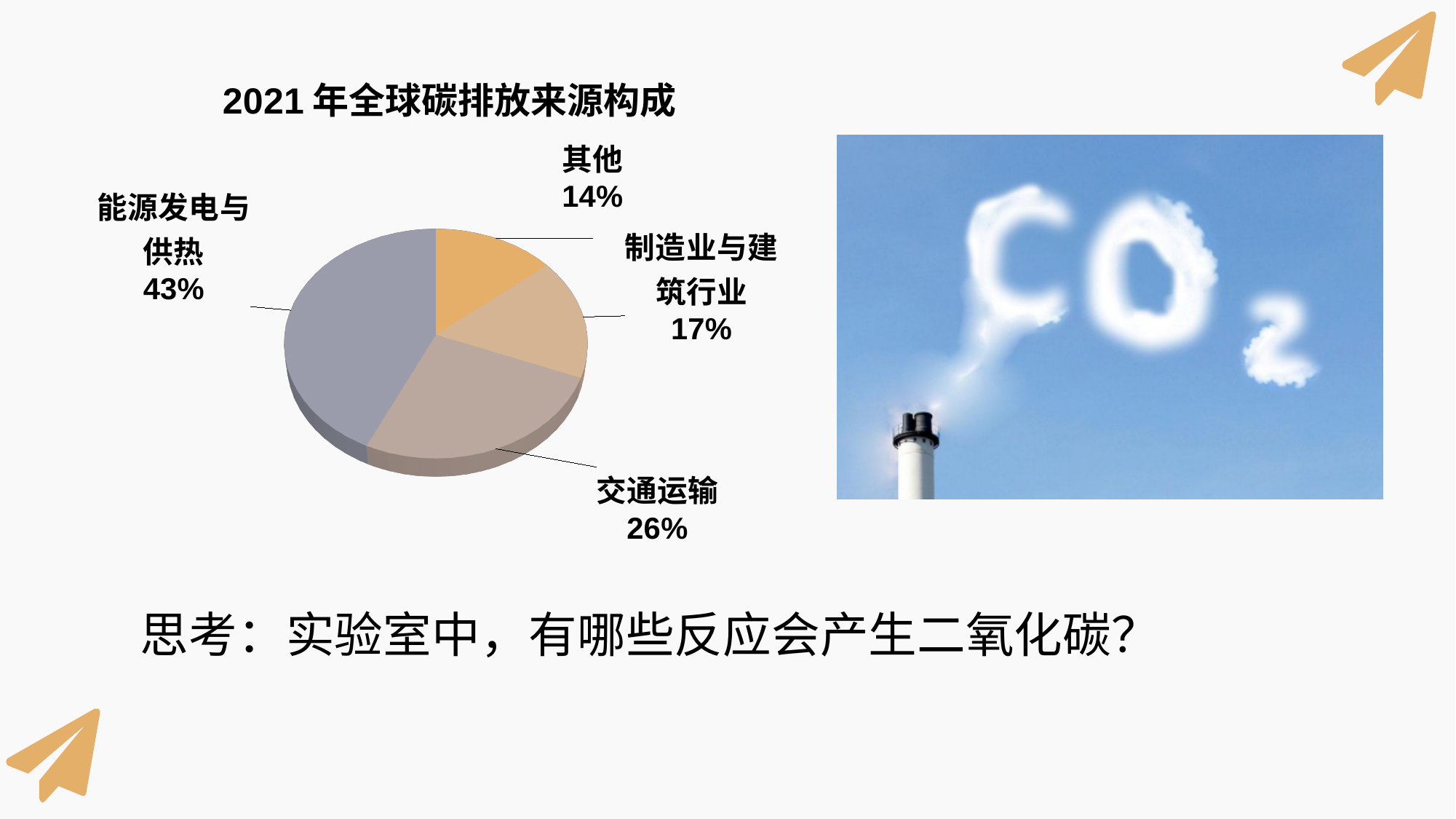
Which is larger, the share of 制造业与建筑行业 or the share of 其他? 制造业与建筑行业 What is the difference between the shares of 能源发电与供热 and 交通运输? 17% Which category has the largest share of the pie? 能源发电与供热 Which category has the smallest share of the pie? 其他 What is the title of the chart? 2021 年全球碳排放来源构成 What is the difference between the shares of 交通运输 and 制造业与建筑行业? 9% What share of the pie does 能源发电与供热 account for? 43% What is the value shown for 制造业与建筑行业? 17% What is the value shown for 其他? 14% How many categories are shown in the pie chart? 4 What is the value shown for 交通运输? 26% What kind of chart is shown on the slide? Pie chart